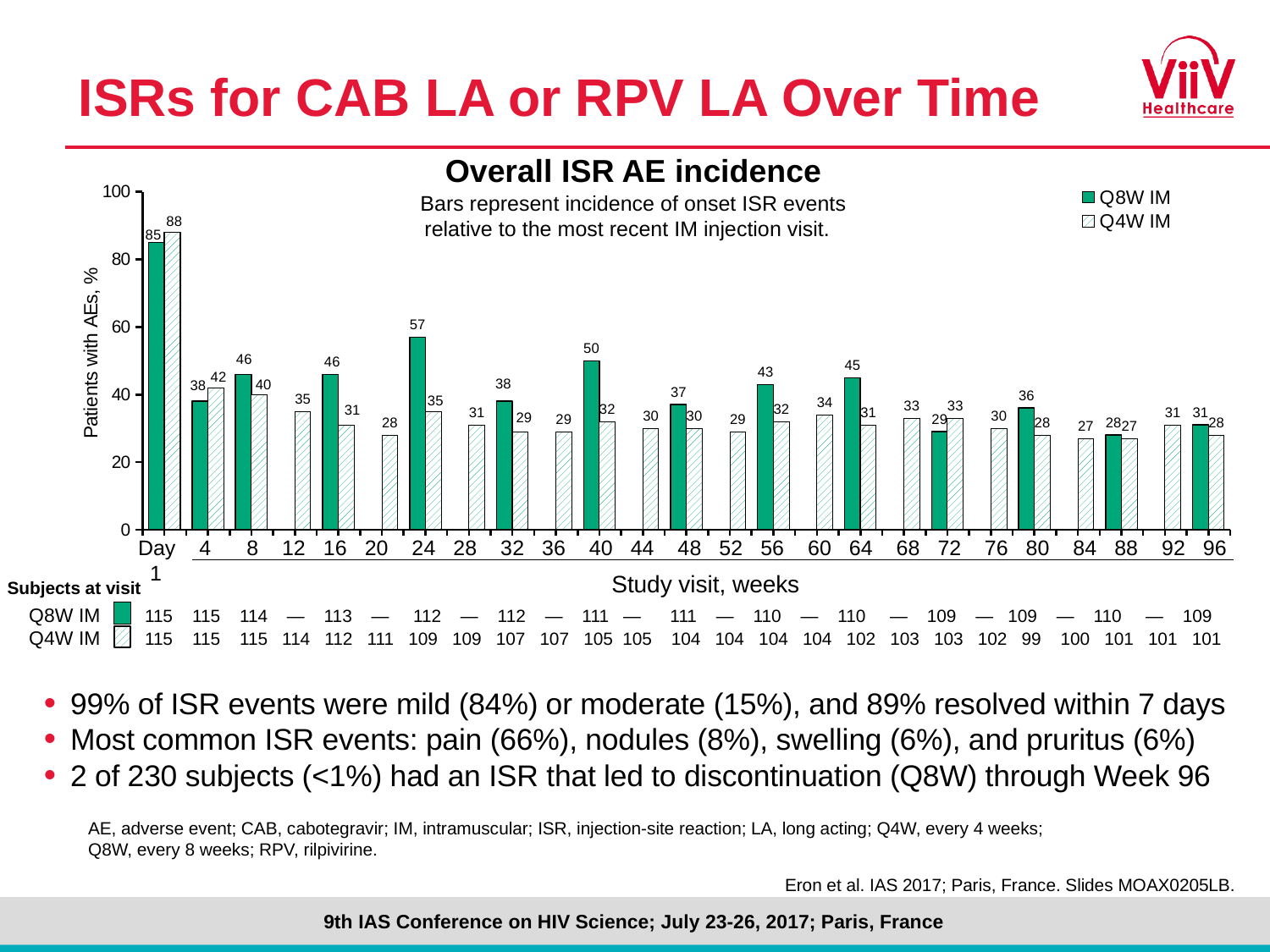
How many series does the legend list? 2 What is the Q4W IM value at Week 84? 27 What is the difference between the Q4W IM values at Day 1 and Week 4? 46 At Week 72, which series has the larger value, Q8W IM or Q4W IM? Q4W IM At which study visit is the Q8W IM value lowest? Week 88 What is the label of the y axis? Patients with AEs, % What kind of chart is shown? Bar chart What is the Q8W IM value at Week 40? 50 What is the difference between the Q8W IM and Q4W IM values at Week 24? 22 What is the Q8W IM value at Day 1? 85 What is the Q4W IM value at Week 24? 35 Excluding Day 1, at which study visit is the Q8W IM value highest? Week 24